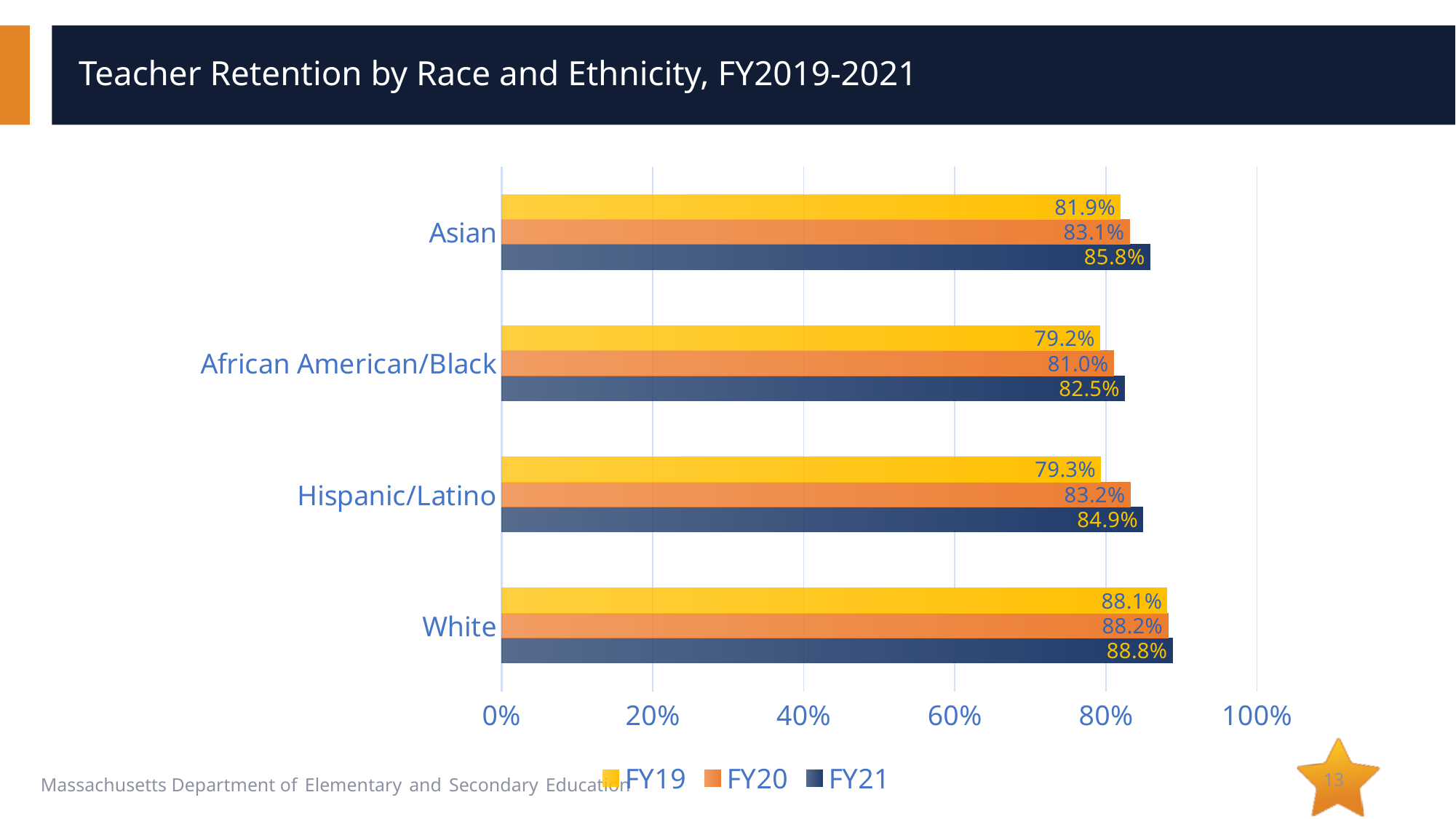
How many series does the legend list? 3 What is the title of the chart? Teacher Retention by Race and Ethnicity, FY2019-2021 What is the FY21 teacher retention rate for Asian teachers? 85.8% What is the FY20 teacher retention rate for African American/Black teachers? 81.0% Which is larger, the FY20 retention rate for Asian teachers or for Hispanic/Latino teachers? Hispanic/Latino What is the FY19 teacher retention rate for Hispanic/Latino teachers? 79.3% Which race/ethnicity group has the highest FY21 retention rate? White Which race/ethnicity group has the lowest FY19 retention rate? African American/Black What kind of chart is shown on the slide? Bar chart How many race/ethnicity categories are shown on the chart? 4 What is the difference between the FY21 and FY19 retention rates for Hispanic/Latino teachers? 5.6% For White teachers, does the retention rate rise or fall from FY19 to FY21? Rise